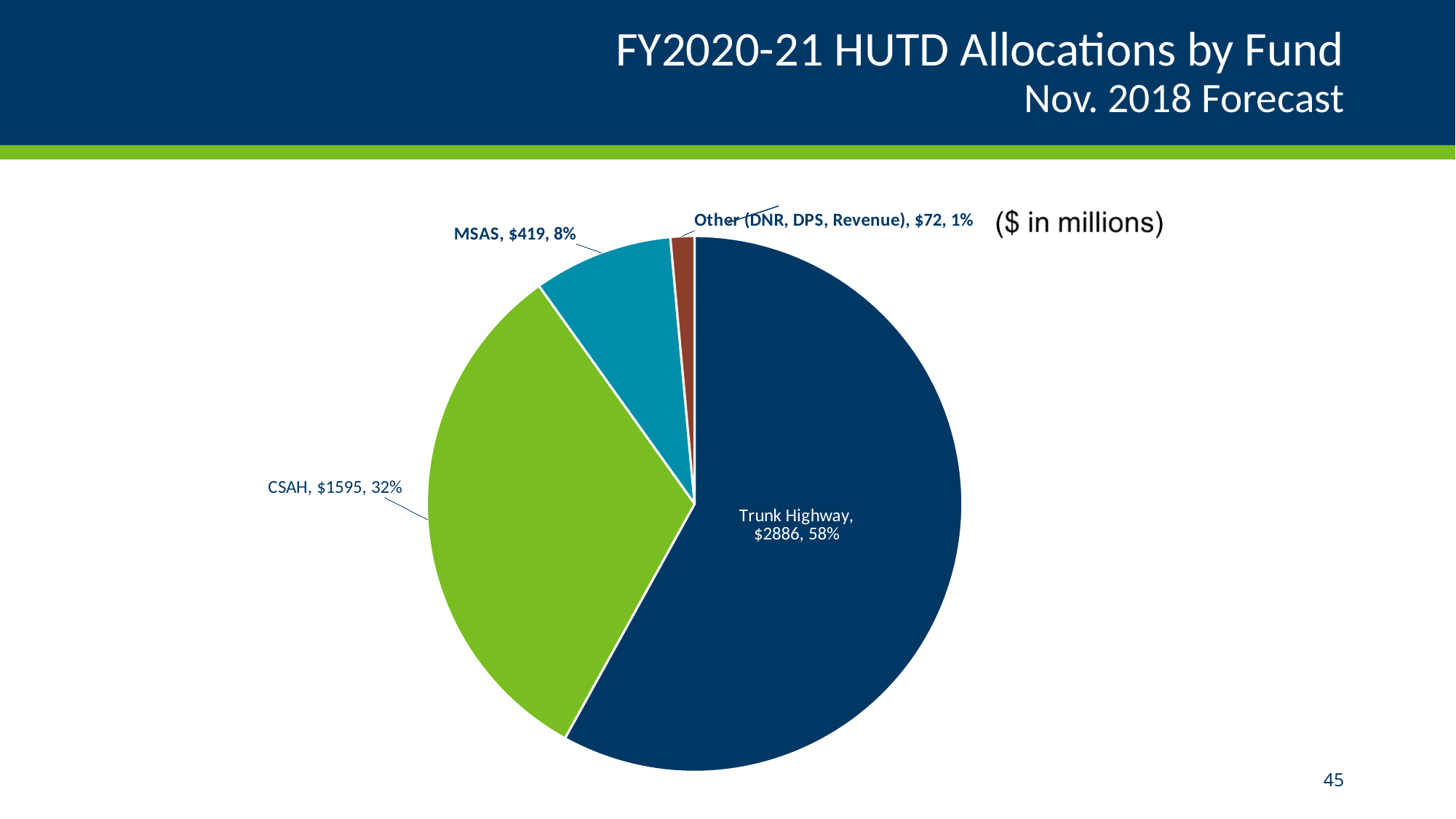
Which is larger, the MSAS allocation or the Other (DNR, DPS, Revenue) allocation? MSAS What is the allocation for MSAS? $419 What is the allocation for CSAH? $1595 What type of chart is shown on the slide? pie chart How many slices does the pie chart have? 4 Which fund receives the smallest share of HUTD allocations? Other (DNR, DPS, Revenue) What is the allocation for Other (DNR, DPS, Revenue)? $72 What percentage share of the pie does CSAH represent? 32% What percentage share of the pie does MSAS represent? 8% Which fund receives the largest share of HUTD allocations? Trunk Highway What is the difference between the Trunk Highway and CSAH allocations? $1291 What is the allocation for Trunk Highway? $2886